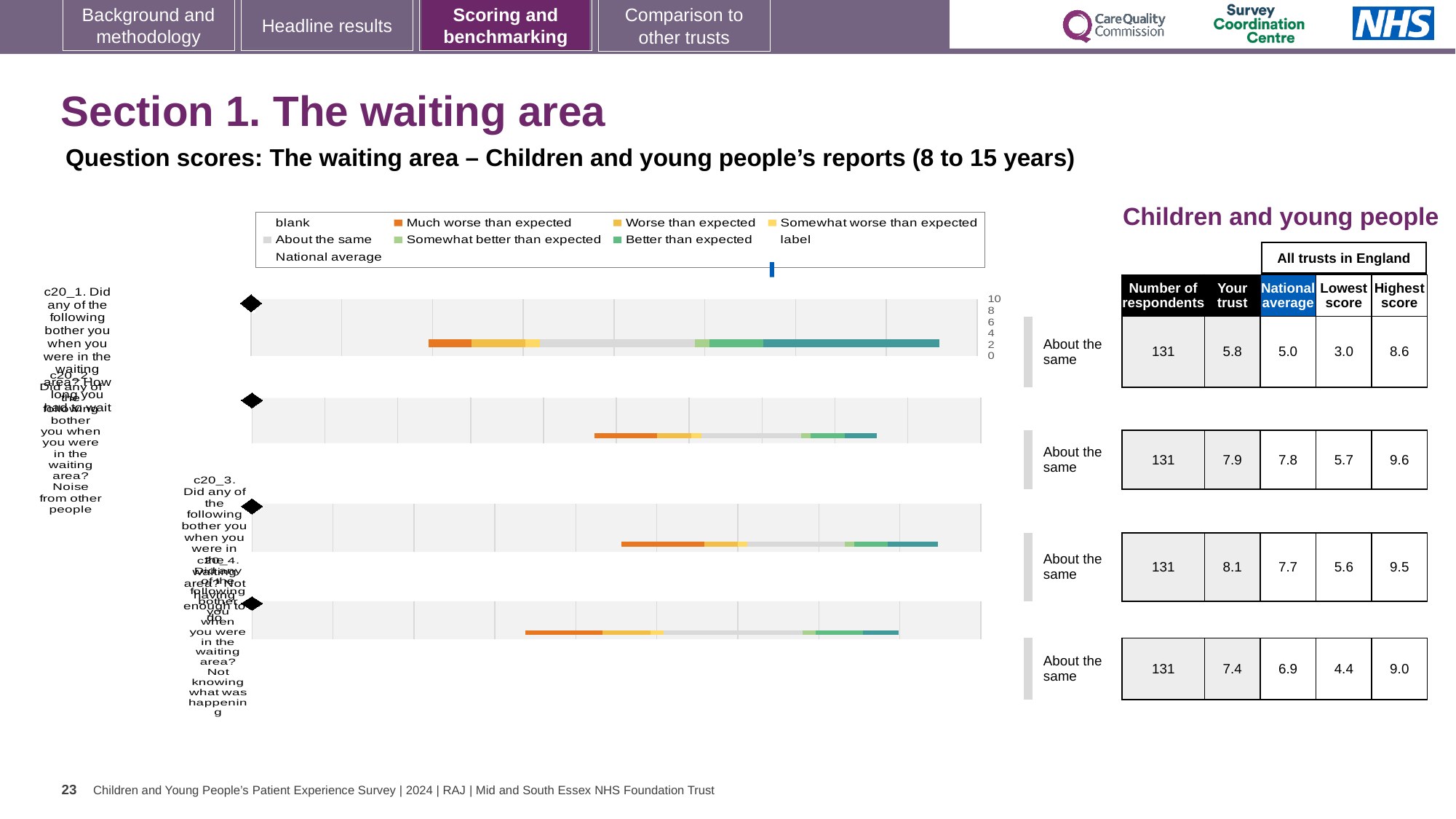
How many respondents are shown for each of the four waiting area questions? 131 For the first question (c20_1), how much higher is the 'Your trust' score than the national average? 0.8 In the table next to the charts, what is the 'Your trust' score for the first question (c20_1, how long you had to wait)? 5.8 How many question charts are shown on the slide? 4 What kind of chart is used for each question on the slide? Bar chart In the table next to the charts, what is the highest score for the second question (c20_2, noise from other people)? 9.6 For the fourth question (c20_4), what is the difference between the highest score and the lowest score? 4.6 For the third question (c20_3), which is larger: the 'Your trust' score or the national average? Your trust (8.1) Which of the four questions has the highest 'Your trust' score? c20_3 (third row), 8.1 In the table next to the charts, what is the national average for the fourth question (c20_4, not knowing what was happening)? 6.9 What benchmark label is shown beside each of the four charts? About the same Which of the four questions has the lowest 'Your trust' score? c20_1 (first row), 5.8